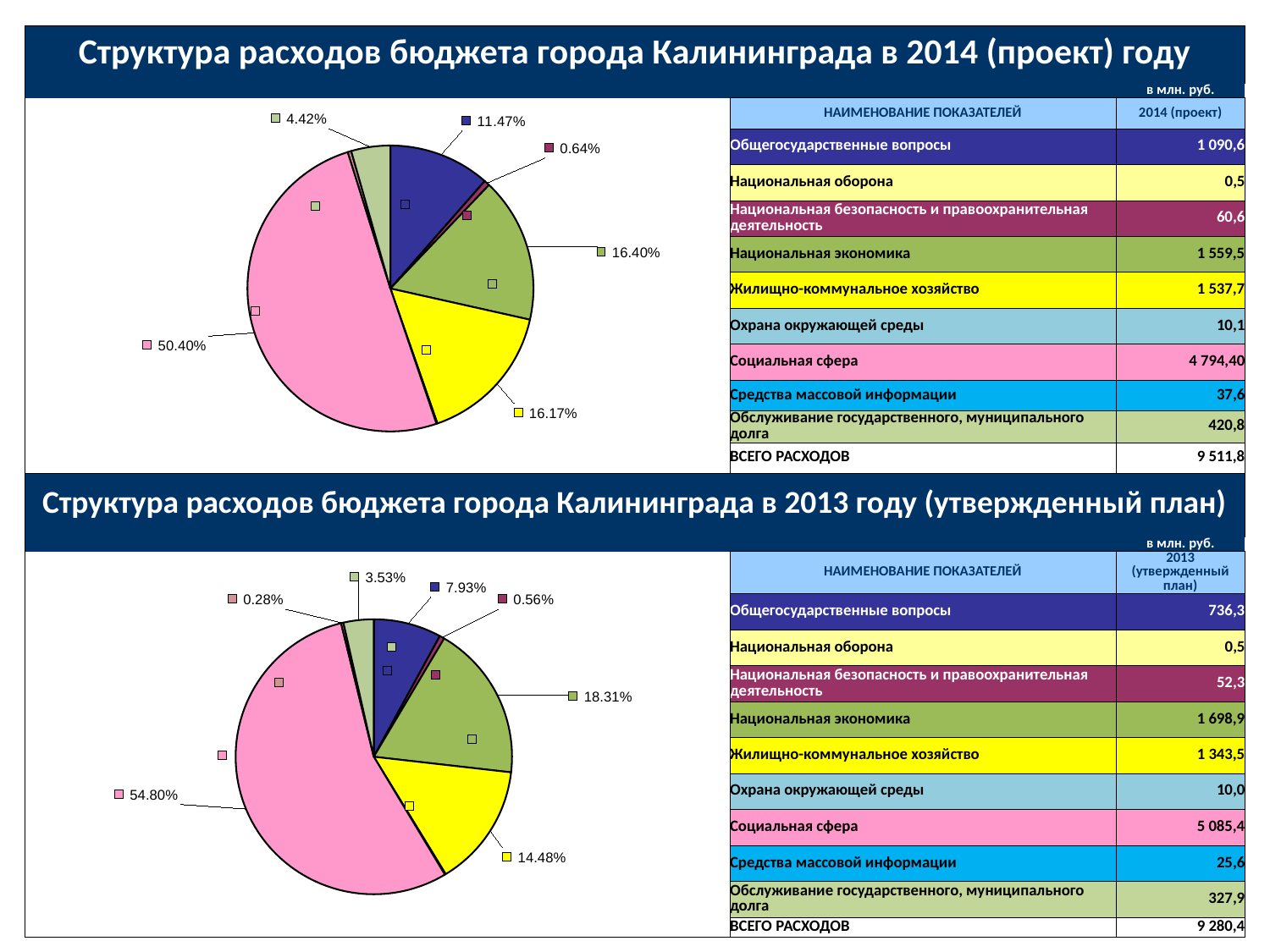
In the bottom pie chart (2013 утвержденный план), is the share of the pink slice greater or less than 50%? greater How many percentage labels are shown on the bottom pie chart (2013 утвержденный план)? 7 In the bottom pie chart (2013 утвержденный план), what is the smallest labelled percentage? 0.28% What is the title above the top pie chart? Структура расходов бюджета города Калининграда в 2014 (проект) году In the top pie chart (2014 проект), what colour is the largest slice? pink What kind of chart is shown on the top half of the slide (Структура расходов бюджета города Калининграда в 2014 (проект) году)? pie chart In the top pie chart (2014 проект), what is the percentage of the largest slice? 50.40% Which chart has the larger biggest slice: the top pie chart (2014 проект) or the bottom pie chart (2013 утвержденный план)? the bottom pie chart (54.80%) In the bottom pie chart (2013 утвержденный план), what is the percentage of the largest slice? 54.80% In the top pie chart (2014 проект), what is the smallest labelled percentage? 0.64% How many percentage labels are shown on the top pie chart (2014 проект)? 6 In the top pie chart (2014 проект), which is larger: the green slice labelled 16.40% or the yellow slice labelled 16.17%? the green slice (16.40%)